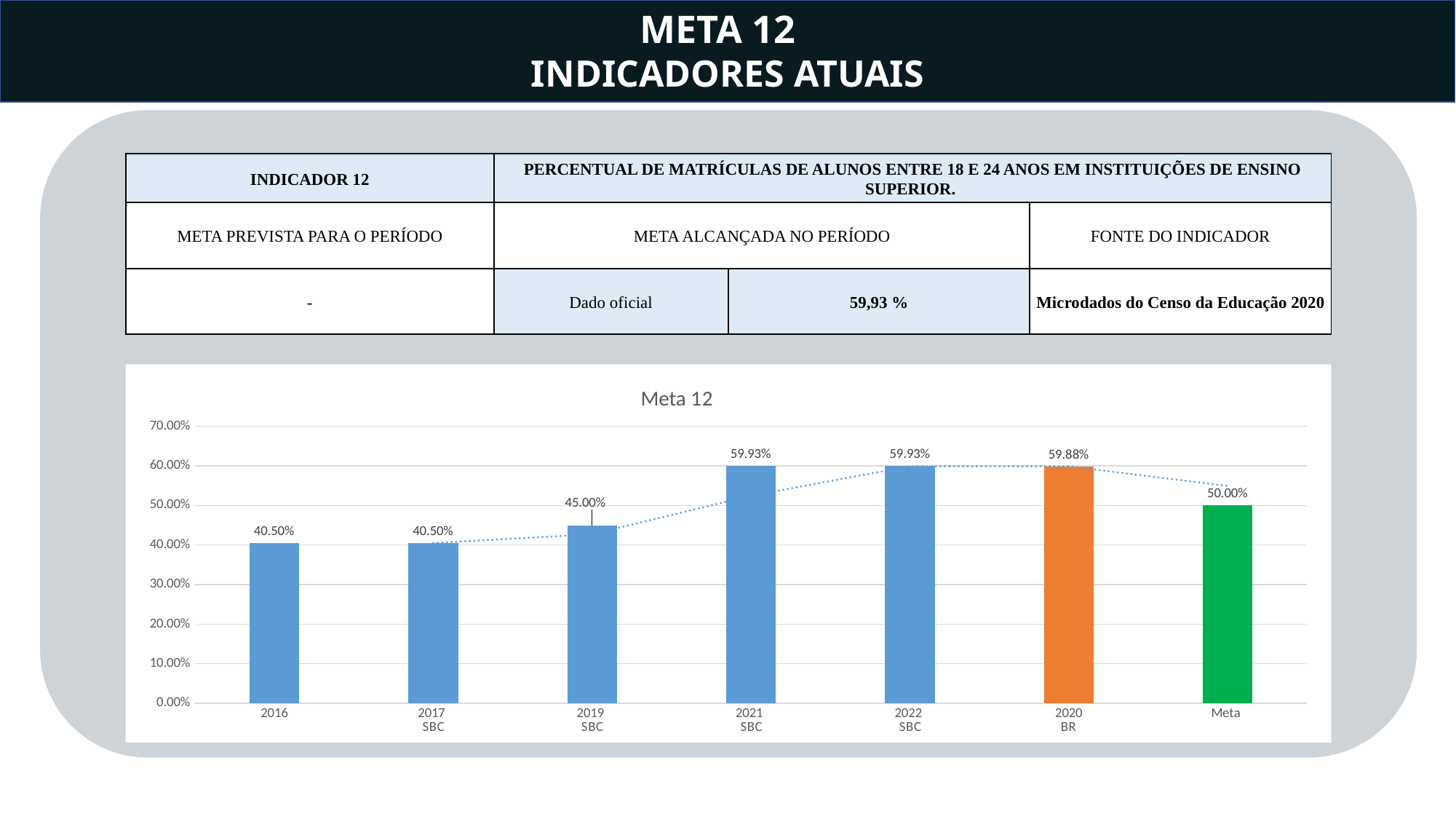
What is the difference between the 2019 SBC value and the 2016 value in the Meta 12 chart? 4.50% What kind of chart is the Meta 12 chart? bar chart What is the value for 2019 SBC in the Meta 12 chart? 45.00% What colour is the Meta bar in the Meta 12 chart? green How many bars are plotted in the Meta 12 chart? 7 By how much does the 2022 SBC value exceed the Meta value in the Meta 12 chart? 9.93% Which is larger in the Meta 12 chart, the value for 2019 SBC or the Meta value? Meta Is the value for 2019 SBC in the Meta 12 chart greater or less than 50.00%? less What is the value of the Meta bar in the Meta 12 chart? 50.00% What is the value for 2016 in the Meta 12 chart? 40.50% Do the values in the Meta 12 chart rise or fall from 2016 to 2022 SBC? rise What is the value for 2020 BR in the Meta 12 chart? 59.88%